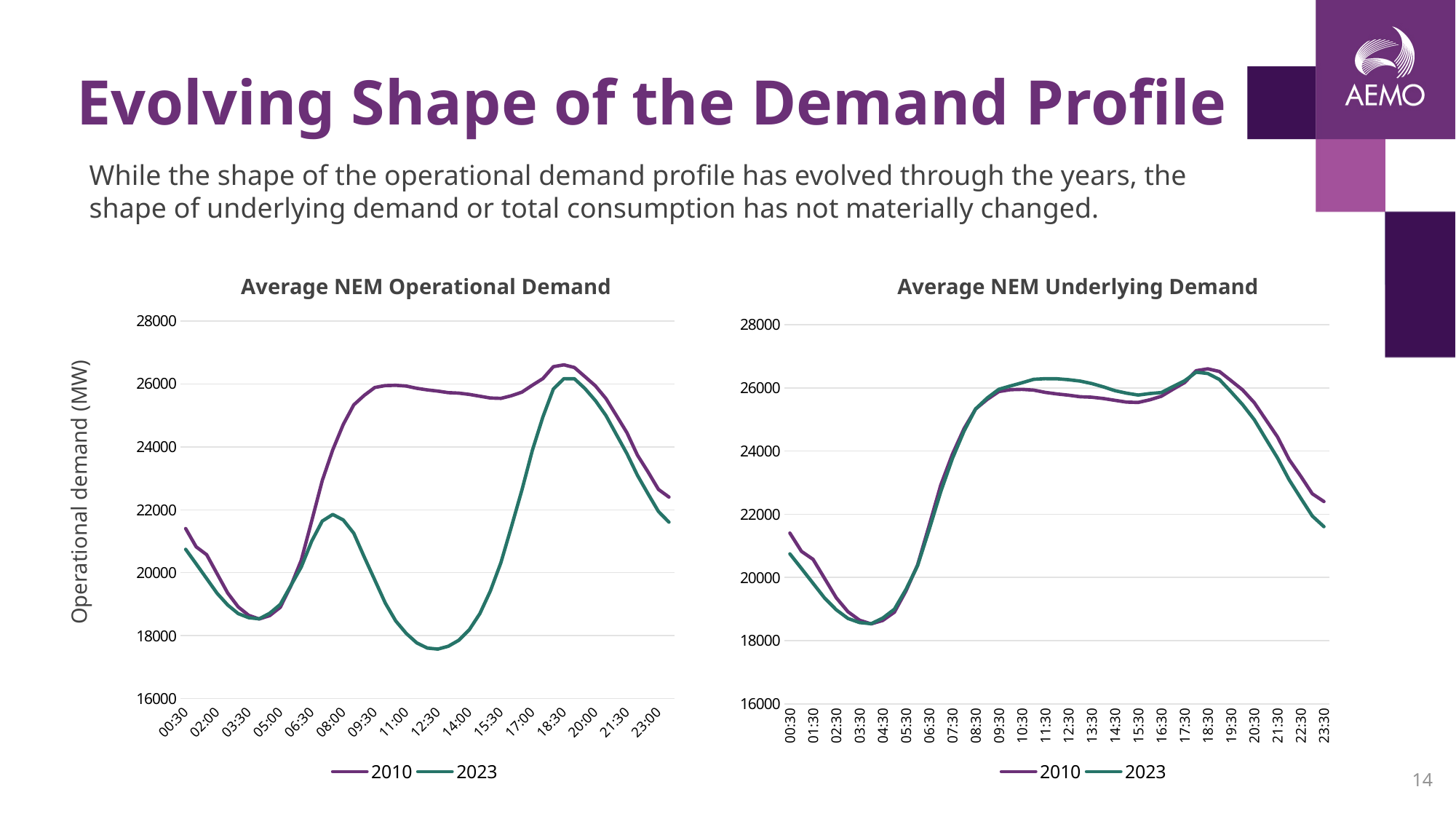
In the 'Average NEM Underlying Demand' chart, which series has the larger value at 23:30, 2010 or 2023? 2010 In the 'Average NEM Operational Demand' chart, is the 2023 value at 12:30 greater or less than 18000? less What is the y-axis label of the 'Average NEM Operational Demand' chart? Operational demand (MW) In the 'Average NEM Underlying Demand' chart, is the 2010 value at 03:30 greater or less than 20000? less In the 'Average NEM Operational Demand' chart, does the 2023 line rise or fall between 08:00 and 12:30? fall In the 'Average NEM Operational Demand' chart, which series has the larger value at 08:00, 2010 or 2023? 2010 In the 'Average NEM Operational Demand' chart, is the 2010 value at 12:30 greater or less than 24000? greater What kind of chart is the 'Average NEM Operational Demand' chart? line chart In the 'Average NEM Operational Demand' chart, which series has the larger value at 12:30, 2010 or 2023? 2010 How many series does the legend of the 'Average NEM Underlying Demand' chart list? 2